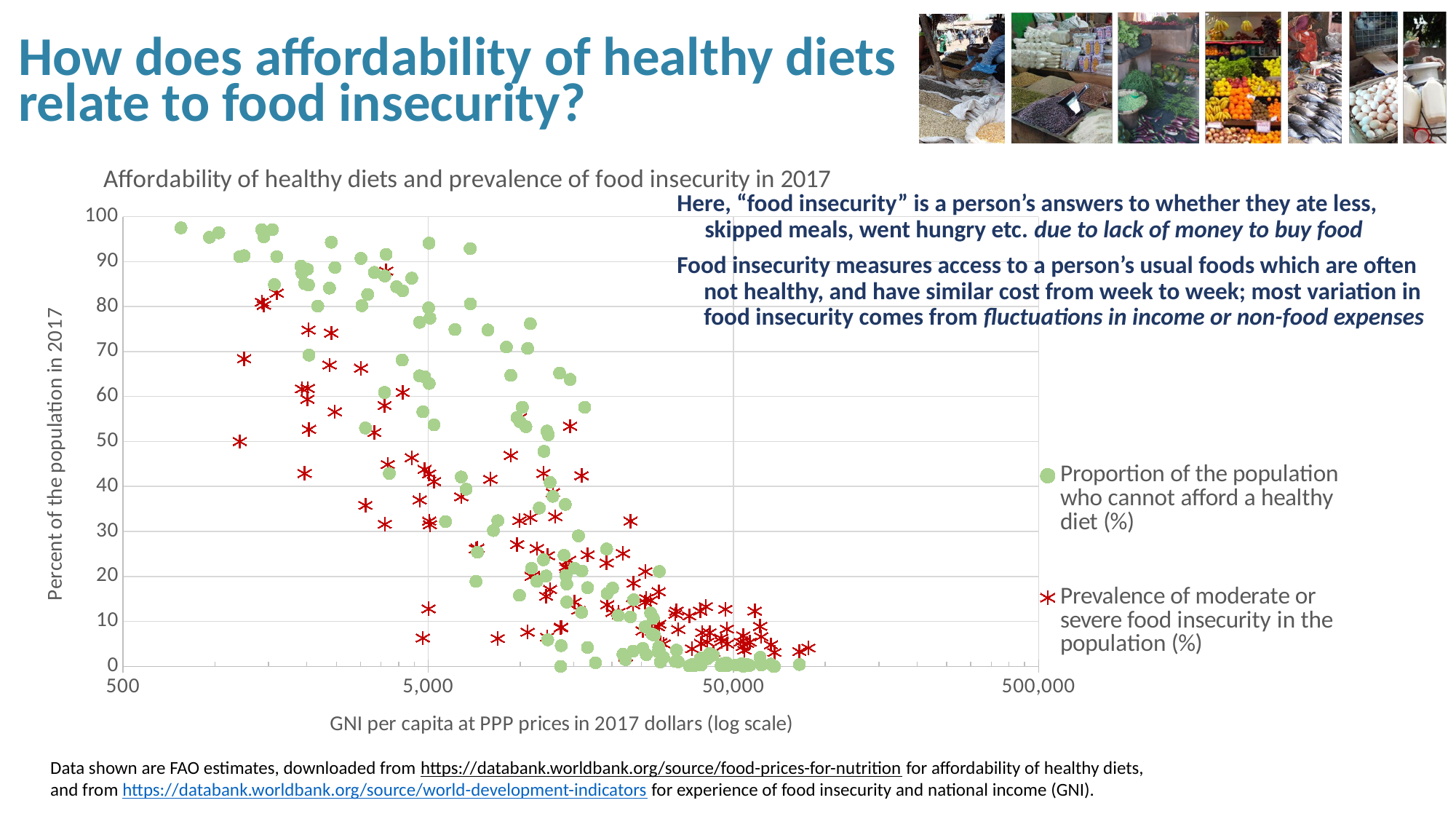
Which series reaches the higher maximum value on the chart: the proportion who cannot afford a healthy diet or the prevalence of moderate or severe food insecurity? Proportion of the population who cannot afford a healthy diet (%) What kind of chart is shown on the slide? Scatter chart As GNI per capita increases along the x axis, do the values for the proportion of the population who cannot afford a healthy diet generally rise or fall? Fall Is the highest plotted value for the prevalence of moderate or severe food insecurity greater or less than 90? less Is the highest plotted value for the proportion of the population who cannot afford a healthy diet greater or less than 90? greater As GNI per capita increases along the x axis, do the values for the prevalence of moderate or severe food insecurity generally rise or fall? Fall What is the label of the chart's x axis? GNI per capita at PPP prices in 2017 dollars (log scale) What is the largest tick value shown on the chart's x axis? 500,000 What is the highest value shown on the chart's y axis? 100 How many series does the chart's legend list? 2